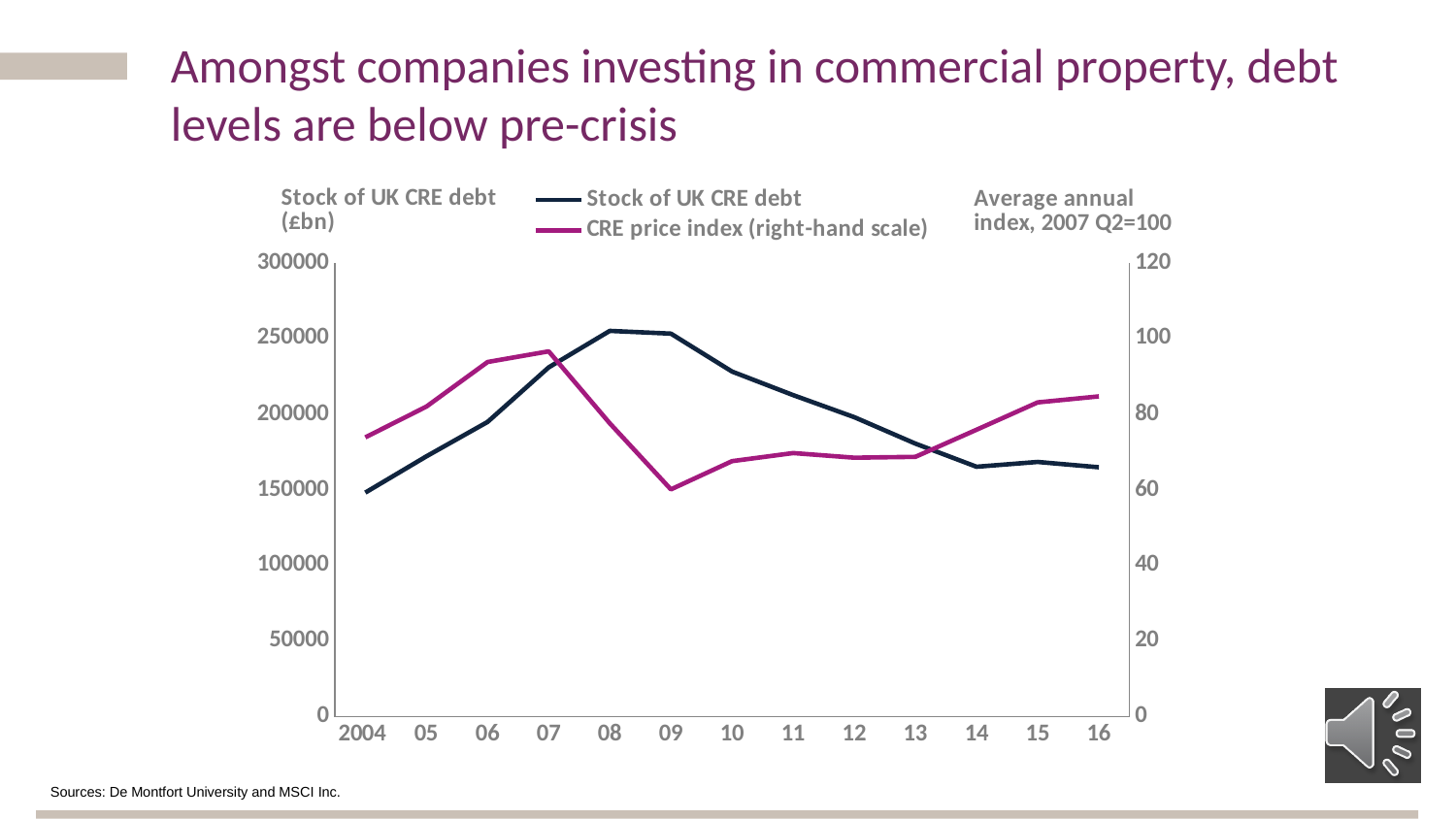
In which year is the Stock of UK CRE debt at its lowest? 2004 In which year does the CRE price index reach its lowest value? 09 In which year does the CRE price index reach its highest value? 07 How many series does the chart's legend list? 2 Is the Stock of UK CRE debt in 2016 greater or less than 200000? less Which is larger: the Stock of UK CRE debt in 2004 or in 2008? 2008 What kind of chart is shown on the slide? line chart Does the Stock of UK CRE debt rise or fall between 2008 and 2016? fall Is the Stock of UK CRE debt in 2008 greater or less than 200000? greater How many years are labelled along the x axis of the chart? 13 Is the CRE price index in 2009 greater or less than 80? less Which series is plotted on the right-hand scale? CRE price index